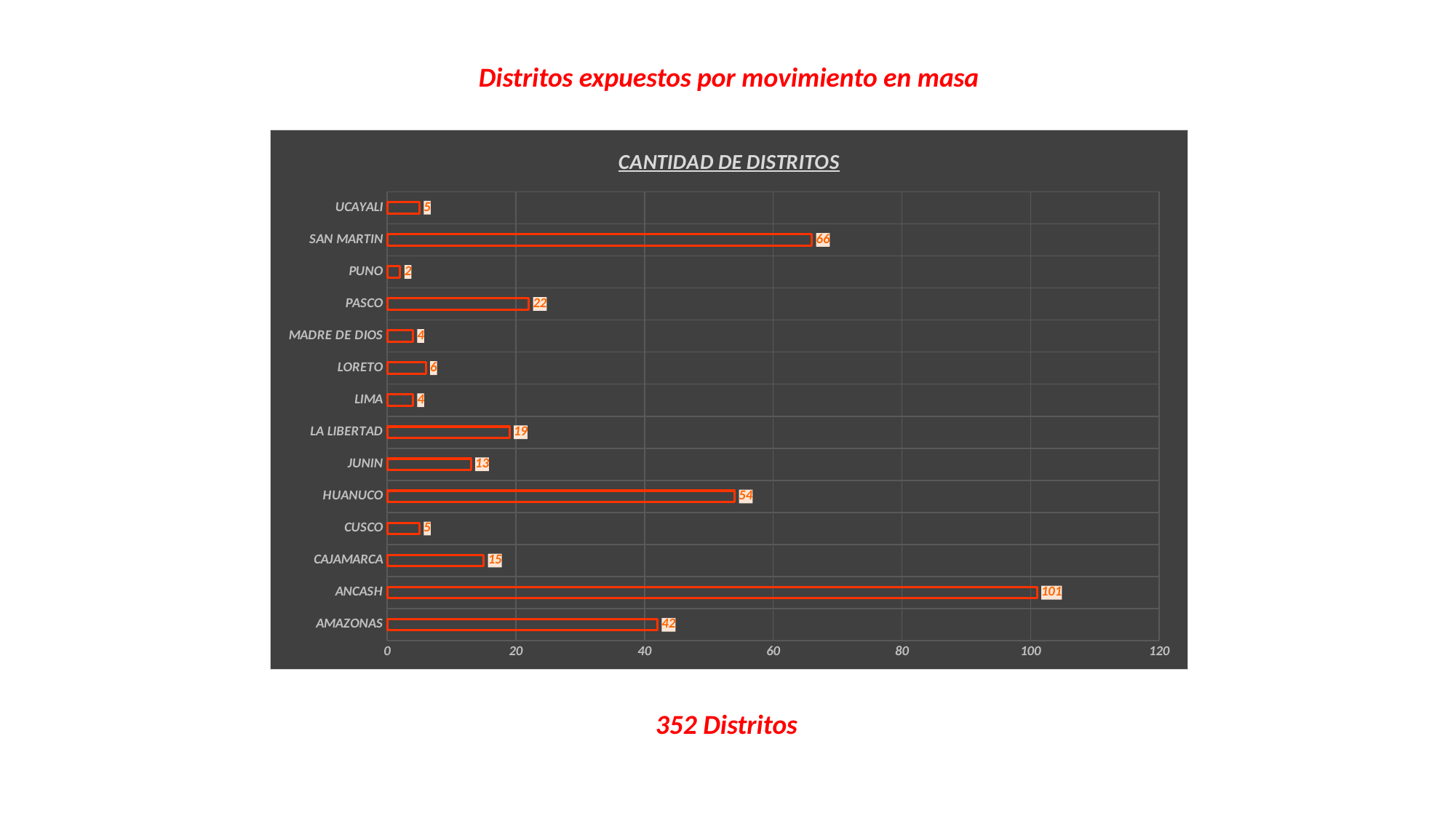
Which category has the highest value? ANCASH How many categories are shown in the chart? 14 What kind of chart is shown? bar chart What is the value for PASCO? 22 What is the value for SAN MARTIN? 66 What is the title of the chart? CANTIDAD DE DISTRITOS What is the value for ANCASH? 101 What is the difference between the values for ANCASH and SAN MARTIN? 35 Which category has the lowest value? PUNO Is the value for HUANUCO greater or less than 40? greater Which is larger, the value for LA LIBERTAD or the value for CAJAMARCA? LA LIBERTAD What is the difference between the values for HUANUCO and AMAZONAS? 12